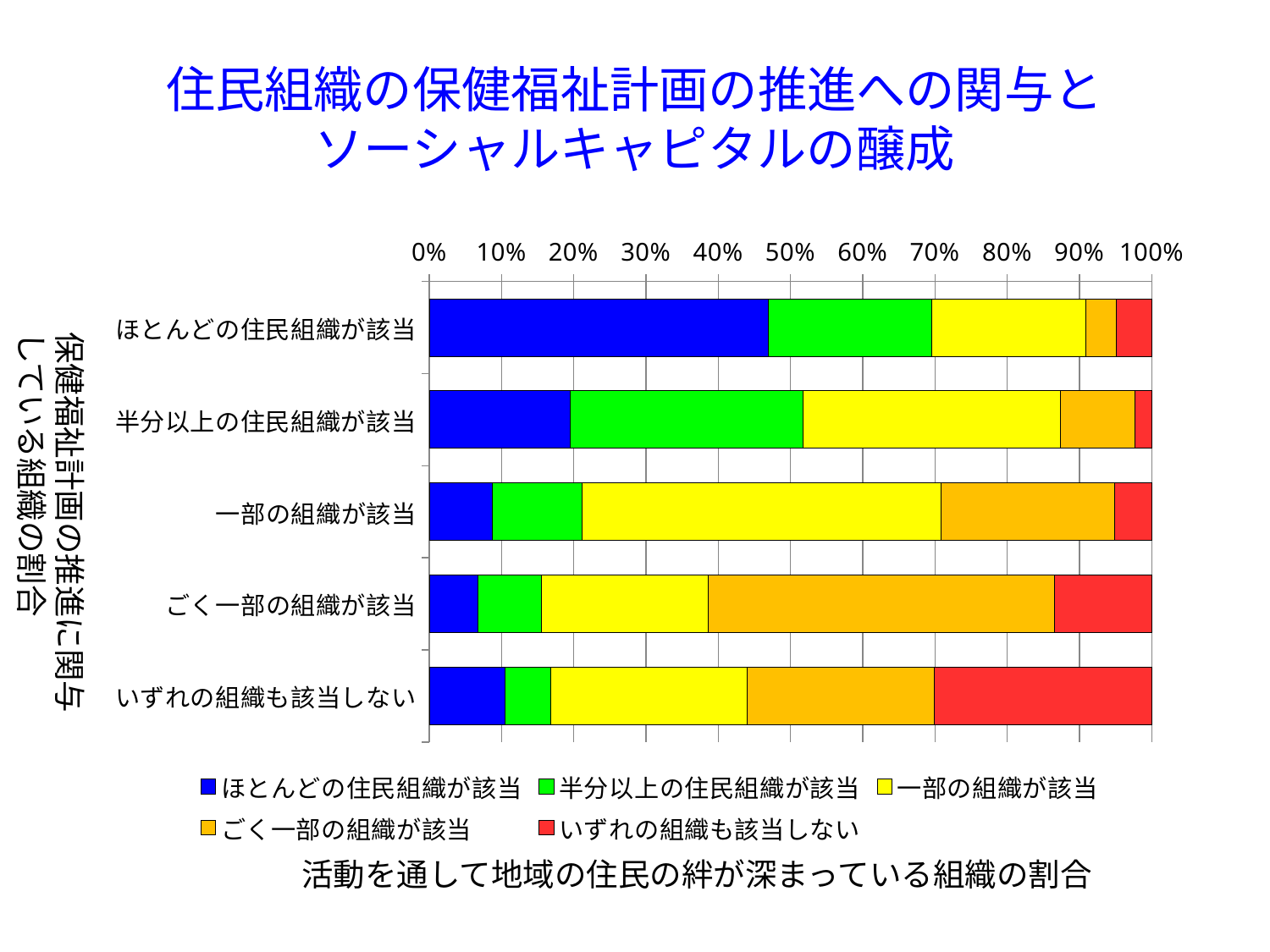
Which category has the largest blue (ほとんどの住民組織が該当) segment? ほとんどの住民組織が該当 Is the blue (ほとんどの住民組織が該当) segment for the category ほとんどの住民組織が該当 greater or less than 40%? greater Which category has the largest red (いずれの組織も該当しない) segment? いずれの組織も該当しない What is the total of the stacked bar for the category ごく一部の組織が該当? 100% Which is larger: the blue segment for ほとんどの住民組織が該当 or the blue segment for いずれの組織も該当しない? ほとんどの住民組織が該当 How many categories are shown on the vertical axis of the chart? 5 What is the label of the horizontal axis at the bottom of the chart? 活動を通して地域の住民の絆が深まっている組織の割合 How many series does the legend list? 5 Which category has the largest orange (ごく一部の組織が該当) segment? ごく一部の組織が該当 Is the red (いずれの組織も該当しない) segment for the category いずれの組織も該当しない greater or less than 20%? greater Is the orange (ごく一部の組織が該当) segment for the category ごく一部の組織が該当 greater or less than 40%? greater What kind of chart is shown on the slide? Stacked bar chart